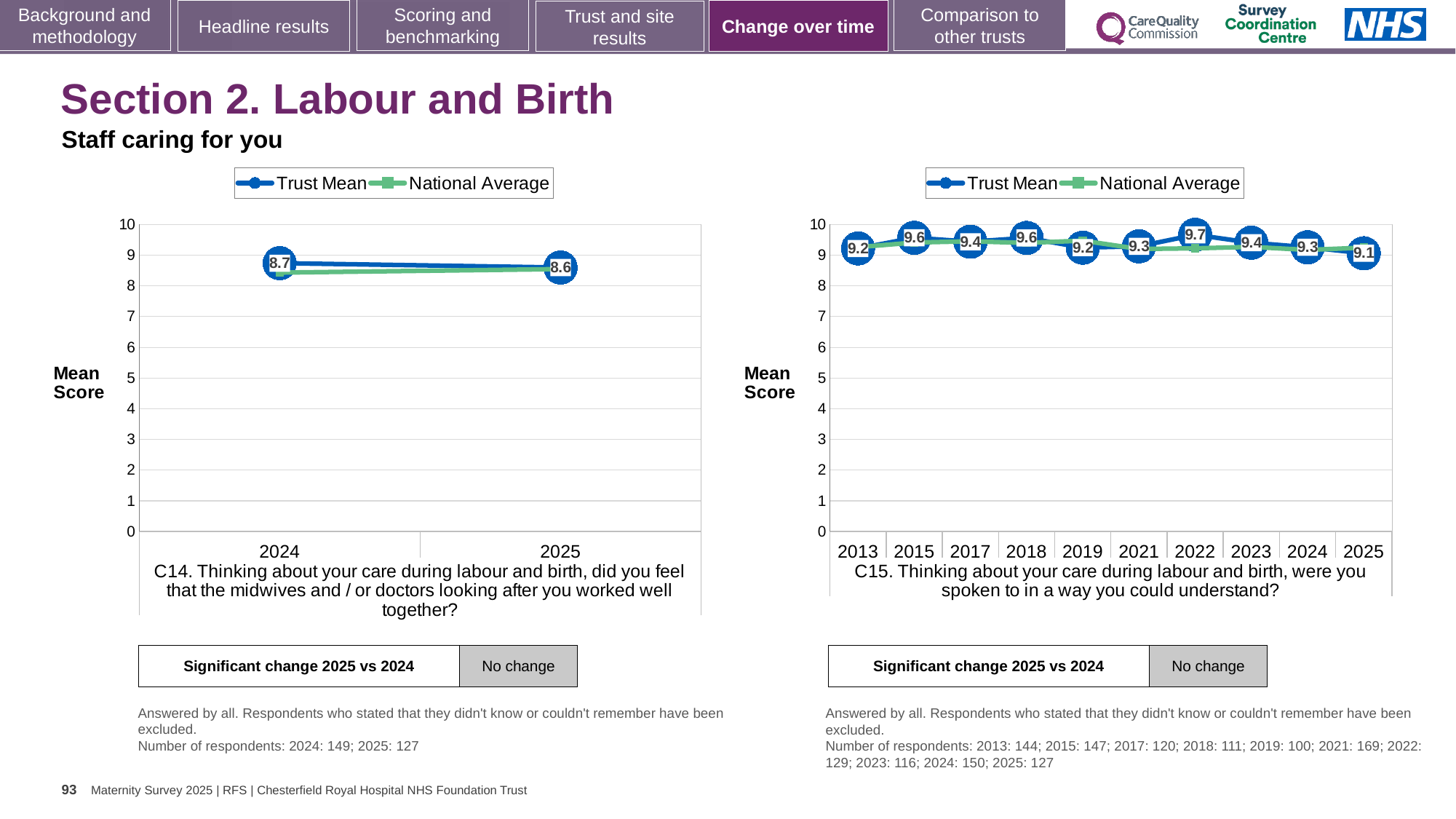
On the right chart (C15), what is the Trust Mean score for 2025? 9.1 On the right chart (C15), how many years are plotted on the x axis? 10 On the right chart (C15), is the Trust Mean score for 2015 greater or less than the Trust Mean score for 2019? greater On the right chart (C15), what is the Trust Mean score for 2022? 9.7 On the left chart (C14), what is the Trust Mean score for 2024? 8.7 On the right chart (C15), which year has the highest Trust Mean score? 2022 On the left chart (C14), what is the Trust Mean score for 2025? 8.6 On the left chart (C14), what is the difference between the Trust Mean scores for 2024 and 2025? 0.1 On the left chart (C14), does the Trust Mean rise or fall from 2024 to 2025? fall On the right chart (C15), which year has the lowest Trust Mean score? 2025 How many series does the legend of the left chart (C14) list? 2 What kind of chart is the right chart (C15)? line chart